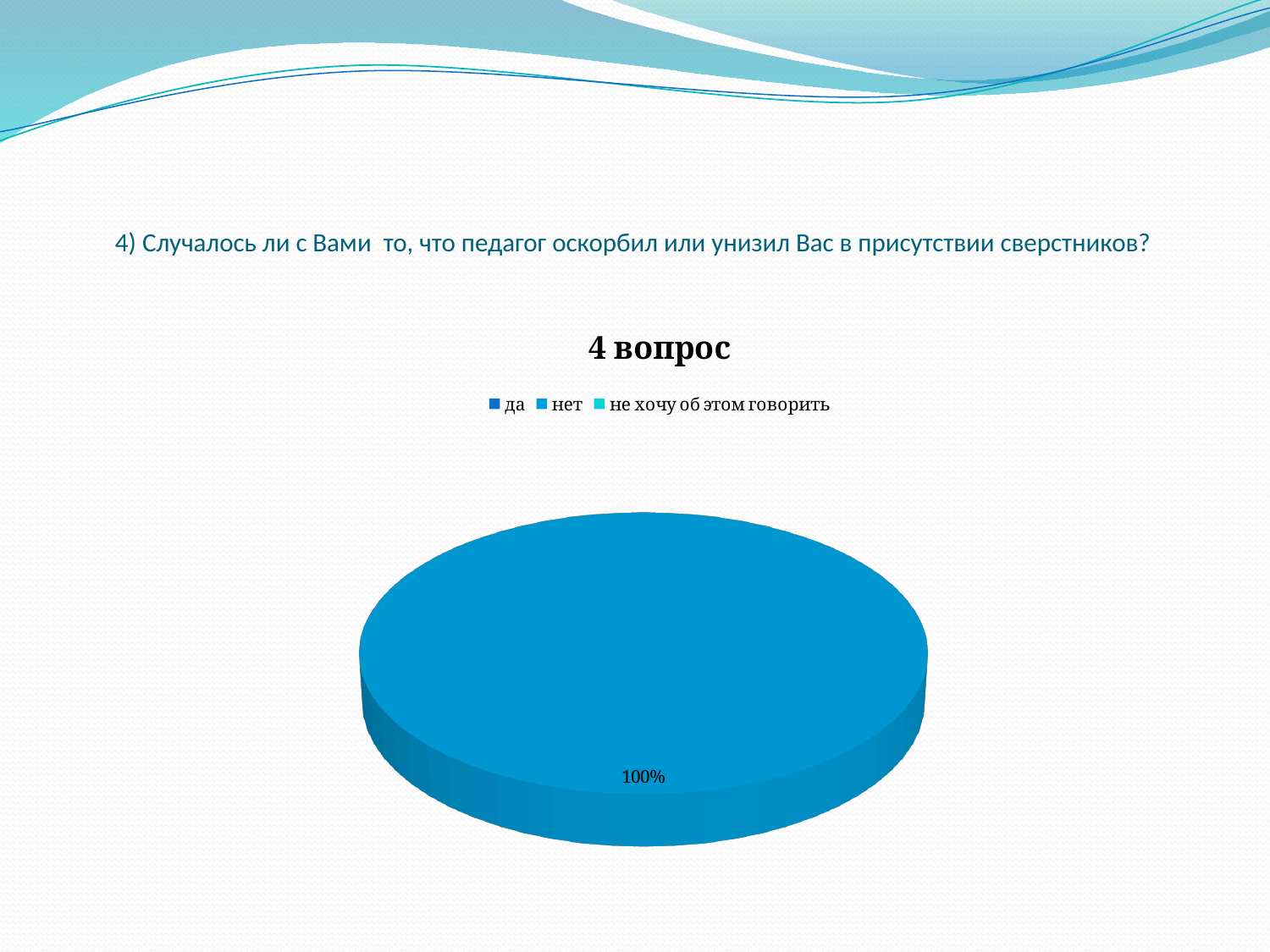
What is the third entry in the chart legend? не хочу об этом говорить What kind of chart is shown on the slide? pie chart Which legend category does the slice labelled 100% belong to? нет What share of the pie does the single visible slice take up? 100% What is the title of the chart? 4 вопрос How many slices are visible in the pie? 1 How many entries does the chart legend list? 3 What percentage label is printed on the pie? 100% Is the value shown on the pie greater or less than 50%? greater